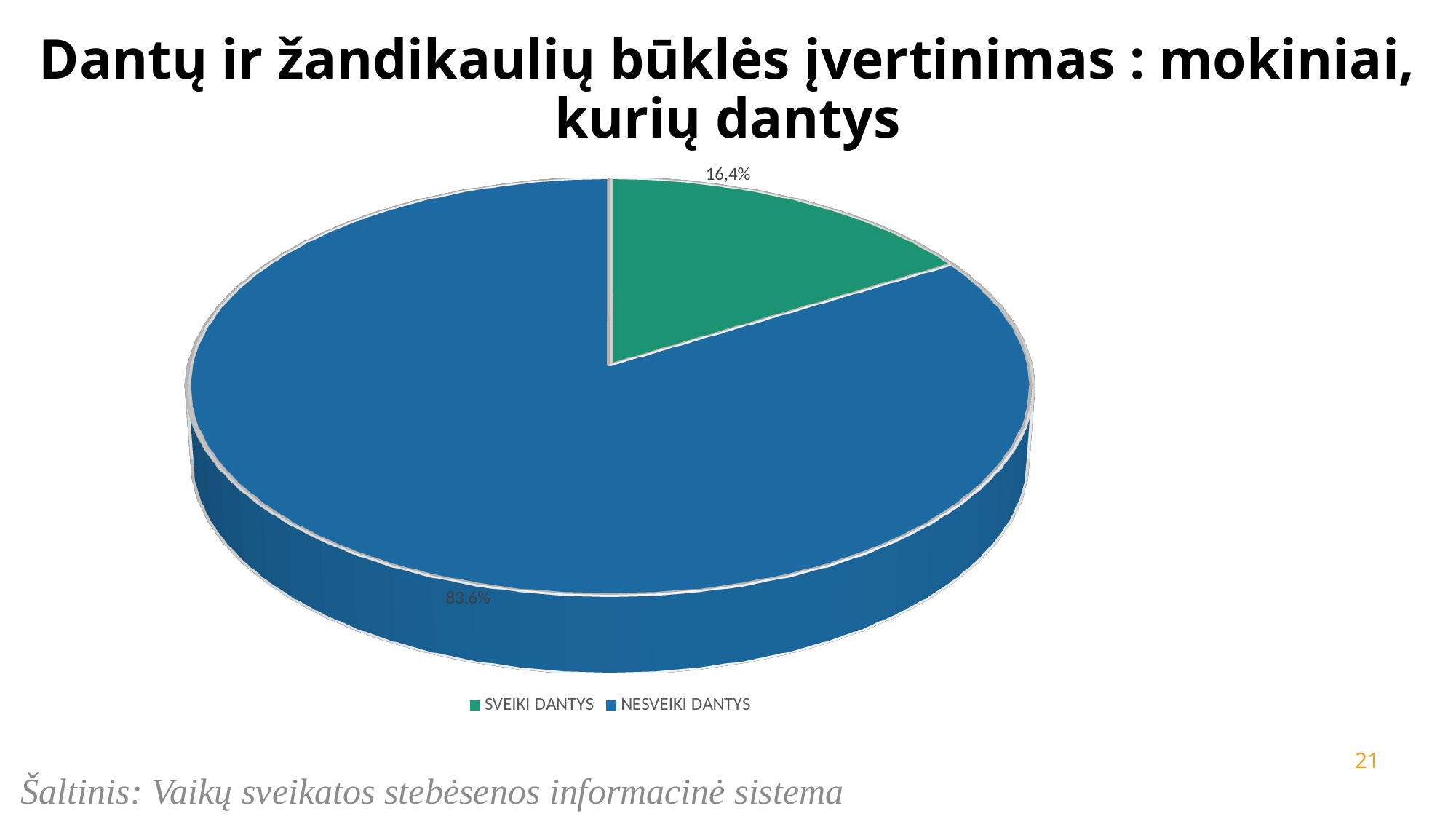
What colour is the SVEIKI DANTYS slice? green What percentage of the pie is labelled SVEIKI DANTYS? 16,4% How many slices does the pie chart have? 2 Which slice of the pie is the largest? NESVEIKI DANTYS What percentage of the pie is labelled NESVEIKI DANTYS? 83,6% How many entries does the legend list? 2 What colour is the NESVEIKI DANTYS slice? blue Which slice of the pie is the smallest? SVEIKI DANTYS What kind of chart is shown on the slide? pie chart Which is larger, the SVEIKI DANTYS slice or the NESVEIKI DANTYS slice? NESVEIKI DANTYS What is the difference in percentage points between the NESVEIKI DANTYS slice and the SVEIKI DANTYS slice? 67,2